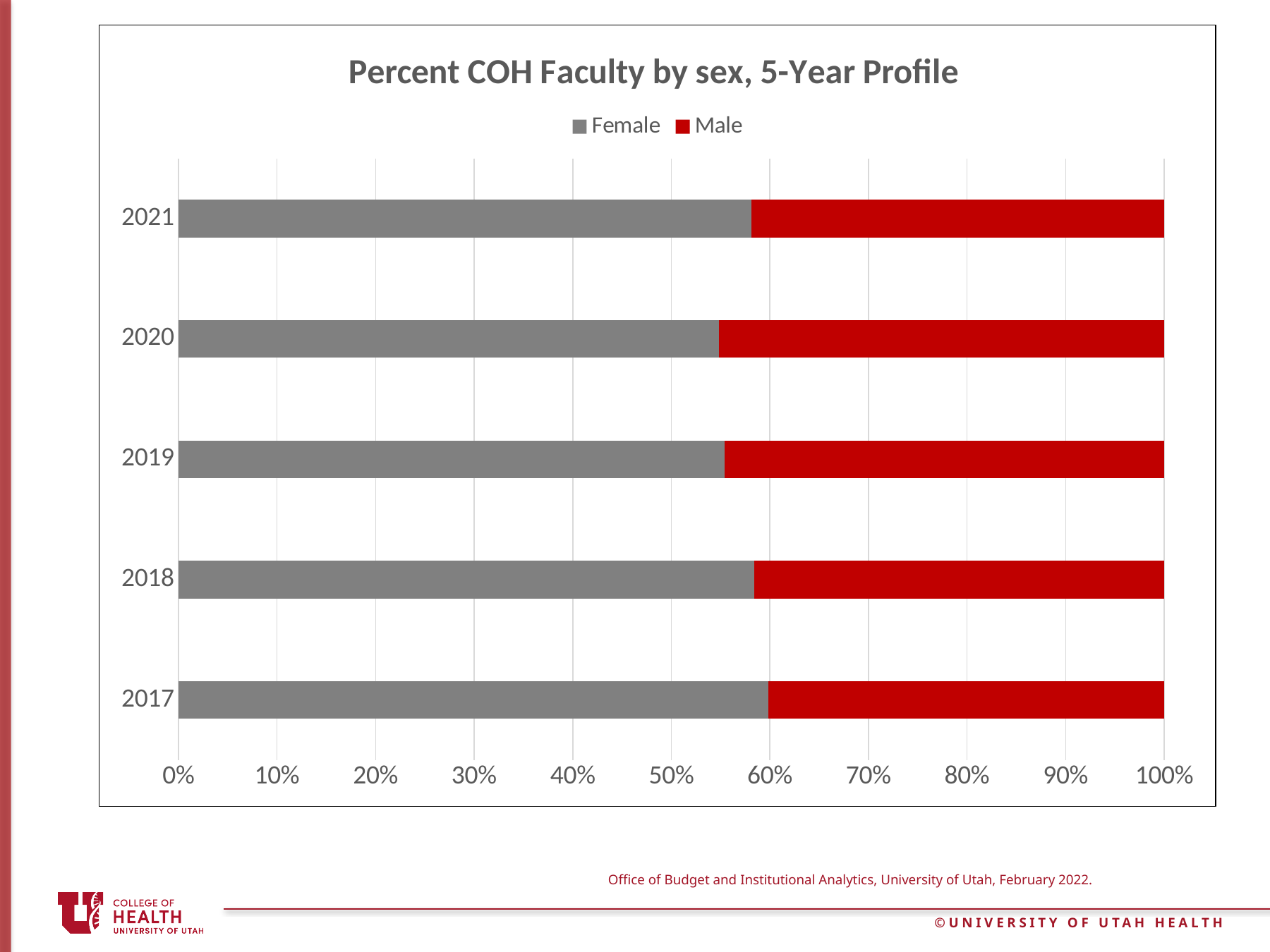
Which is larger, the Male share in 2020 or the Male share in 2017? 2020 Is the Female value for 2021 greater or less than 50%? greater How many series does the legend list? 2 What type of chart is shown on the slide? Stacked bar chart Is the Female value for 2019 greater or less than 50%? greater Which colour represents Male in the chart? Red Which is larger, the Female share in 2021 or the Female share in 2020? 2021 How many years are shown on the chart? 5 Is the Female value for 2020 greater or less than 60%? less What is the title of the chart? Percent COH Faculty by sex, 5-Year Profile What is the maximum value shown on the x axis? 100%